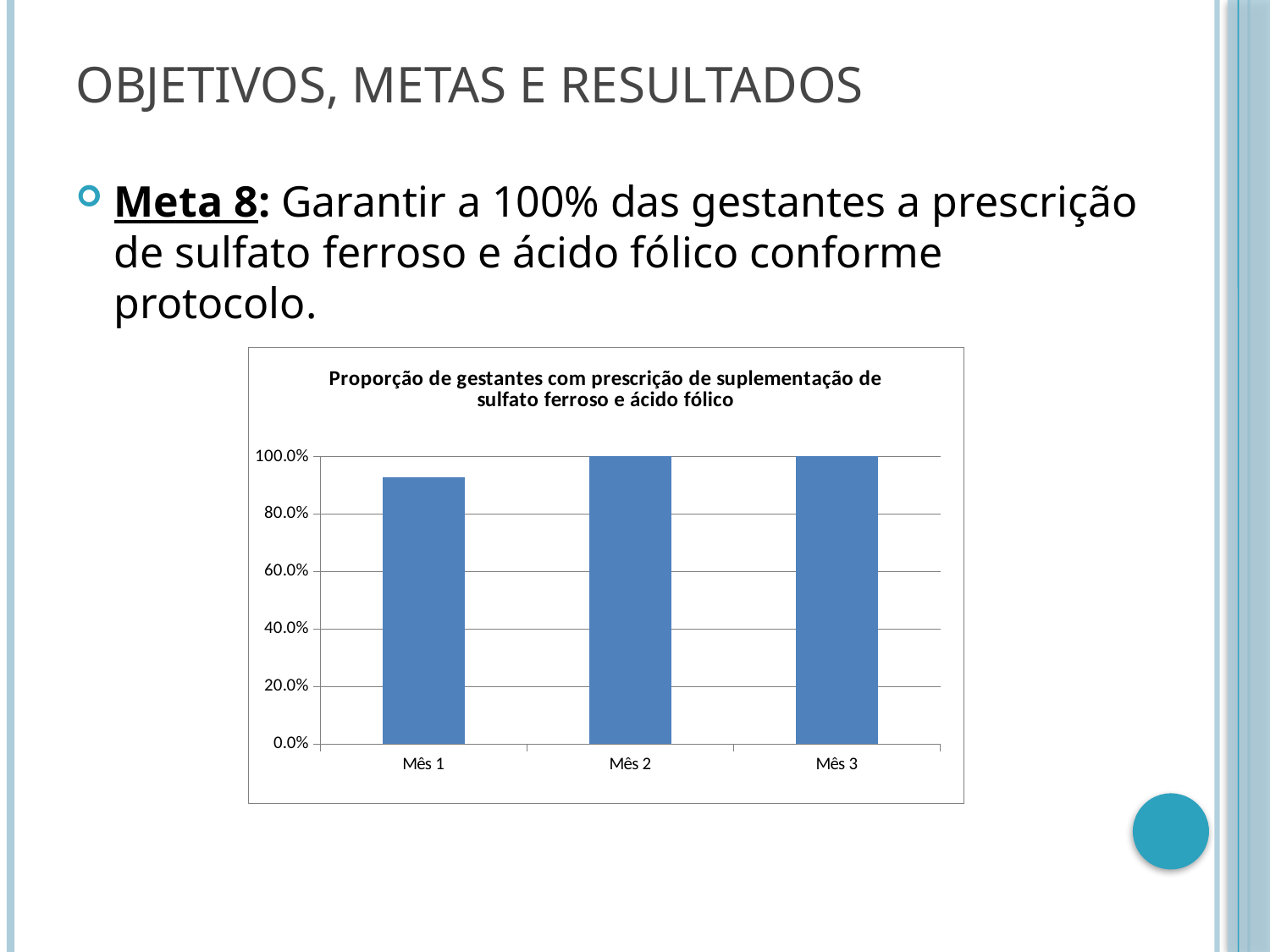
What is the title of the chart? Proporção de gestantes com prescrição de suplementação de sulfato ferroso e ácido fólico Which category has the lowest value in the chart? Mês 1 Which is larger, the value for Mês 1 or the value for Mês 2? Mês 2 What is the value for Mês 3 in the chart? 100.0% Is the value for Mês 1 greater or less than 100.0%? less What is the value for Mês 2 in the chart? 100.0% Is the value for Mês 1 greater or less than 80.0%? greater Does the value rise or fall from Mês 1 to Mês 2? rises What kind of chart is shown on the slide? bar chart How many categories are shown on the x axis of the chart? 3 Which is larger, the value for Mês 3 or the value for Mês 1? Mês 3 What is the highest value shown on the y axis of the chart? 100.0%